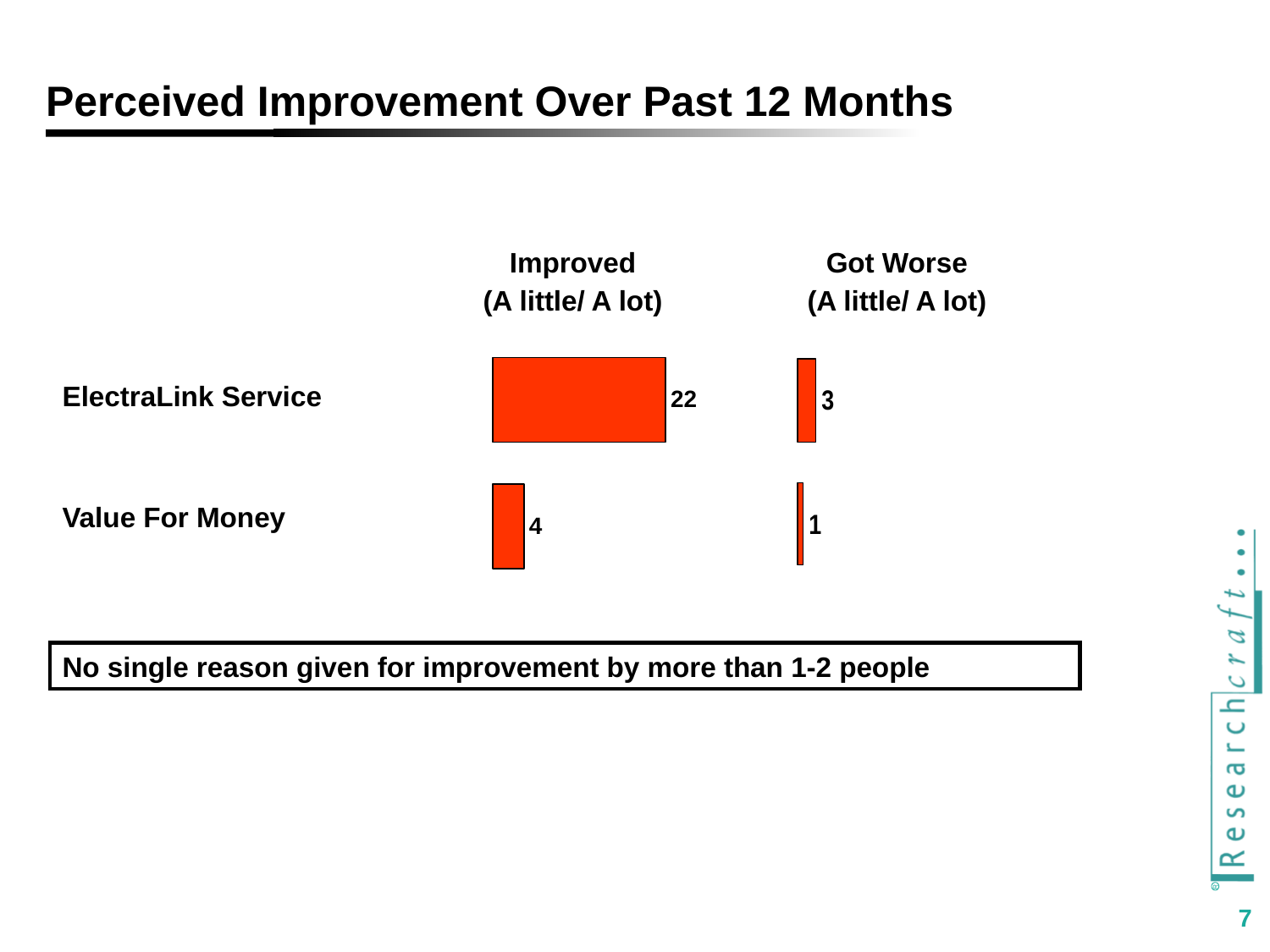
Which category has the lowest 'Got Worse (A little/ A lot)' value? Value For Money How many categories are shown in the chart? 2 What kind of chart is shown on the slide? Bar chart What is the 'Got Worse (A little/ A lot)' value for ElectraLink Service? 3 For ElectraLink Service, what is the difference between the 'Improved' and 'Got Worse' values? 19 Which category has the highest 'Improved (A little/ A lot)' value? ElectraLink Service What is the 'Improved (A little/ A lot)' value for Value For Money? 4 What is the 'Got Worse (A little/ A lot)' value for Value For Money? 1 Which is larger for Value For Money: the 'Improved' value or the 'Got Worse' value? Improved What is the difference between the 'Improved' values for ElectraLink Service and Value For Money? 18 What is the title of the slide containing the chart? Perceived Improvement Over Past 12 Months What is the 'Improved (A little/ A lot)' value for ElectraLink Service? 22